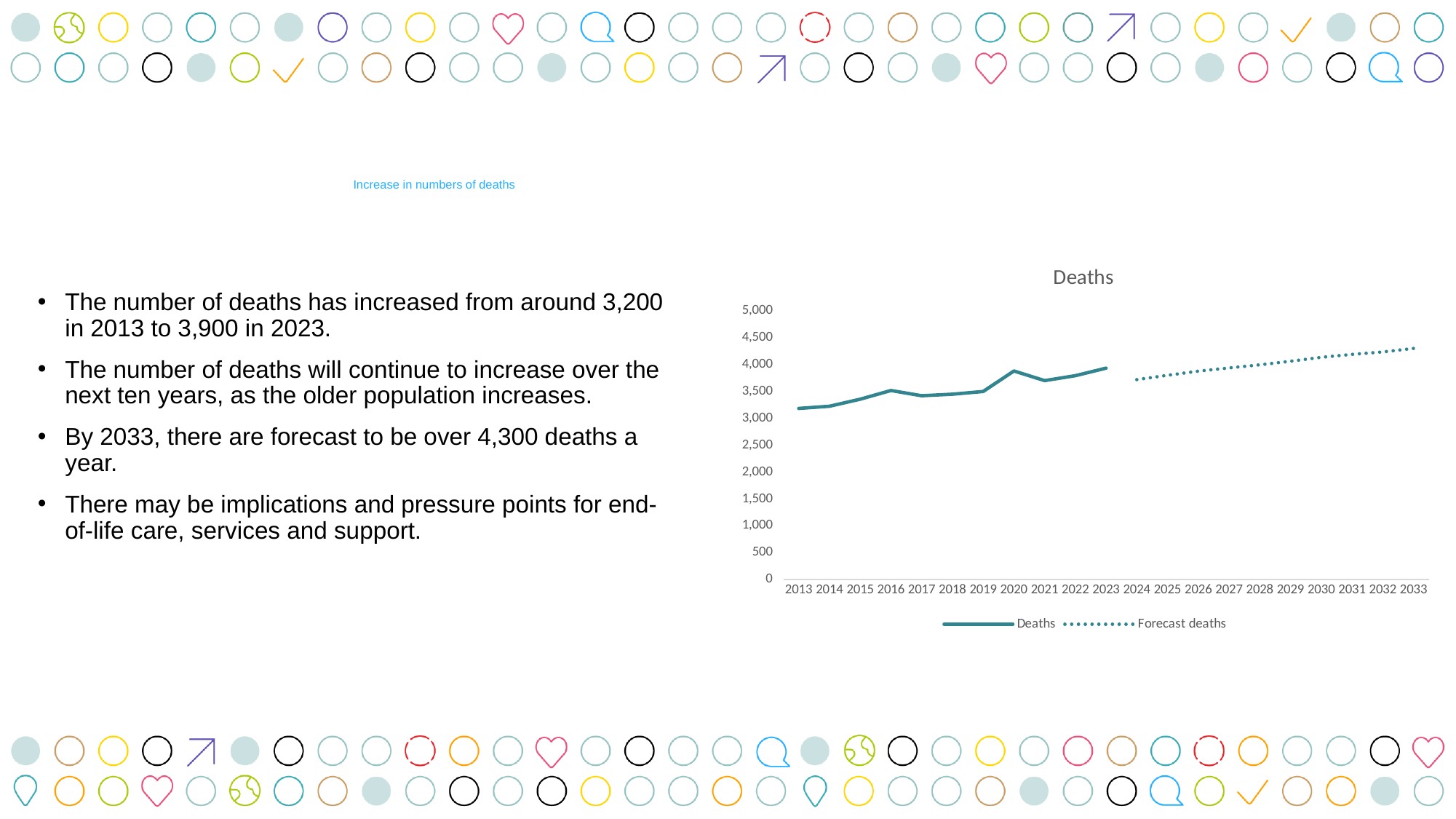
What kind of chart is shown on the slide? Line chart Is the value for Deaths in 2020 greater or less than 3,500? greater What is the title of the chart? Deaths Is the value for Forecast deaths in 2033 greater or less than 4,000? greater Which year has the lowest value for the Deaths series? 2013 How many series does the chart legend list? 2 Is the value for Deaths in 2013 greater or less than 3,500? less How many years are labelled along the x axis of the chart? 21 Do the values in the chart generally rise or fall from 2013 to 2033? Rise Which is larger, the Deaths value in 2013 or the Deaths value in 2023? 2023 Which series in the chart is drawn with a dotted line? Forecast deaths